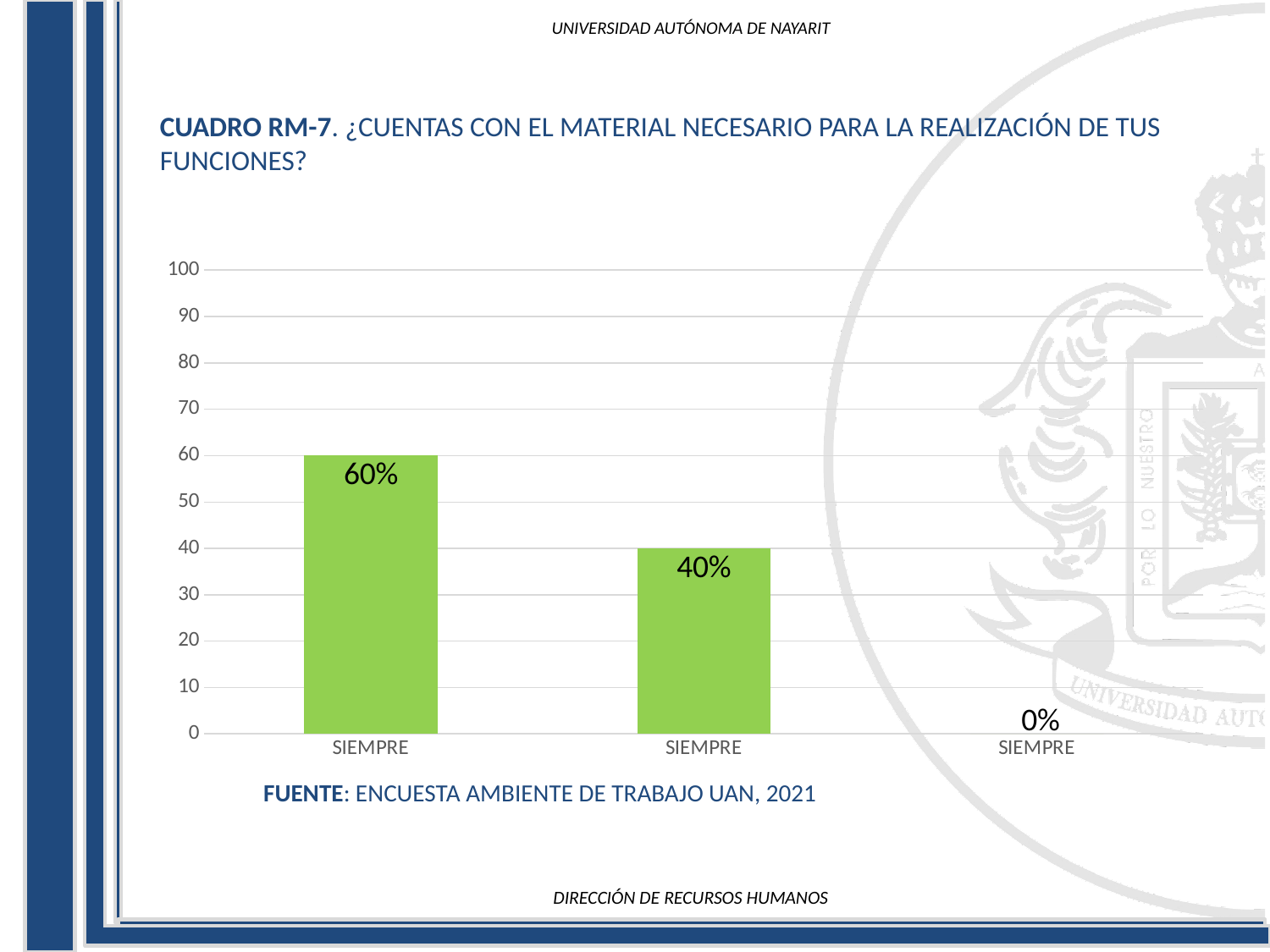
What type of chart is shown on the slide? bar chart How many bars (categories) are plotted on the chart? 3 Which is larger, the value of the first bar or the value of the middle bar? the first bar What is the value shown for the third (rightmost) category? 0% What is the value shown on the first (leftmost) bar? 60% Which bar has the highest value: the first, second or third? the first What is the source cited below the chart? ENCUESTA AMBIENTE DE TRABAJO UAN, 2021 What is the value shown on the middle bar? 40% Which category has the lowest value: the first, second or third? the third What label appears under each of the three categories on the x axis? SIEMPRE What is the difference between the first bar's value and the middle bar's value? 20% Do the values rise or fall from left to right along the x axis? fall